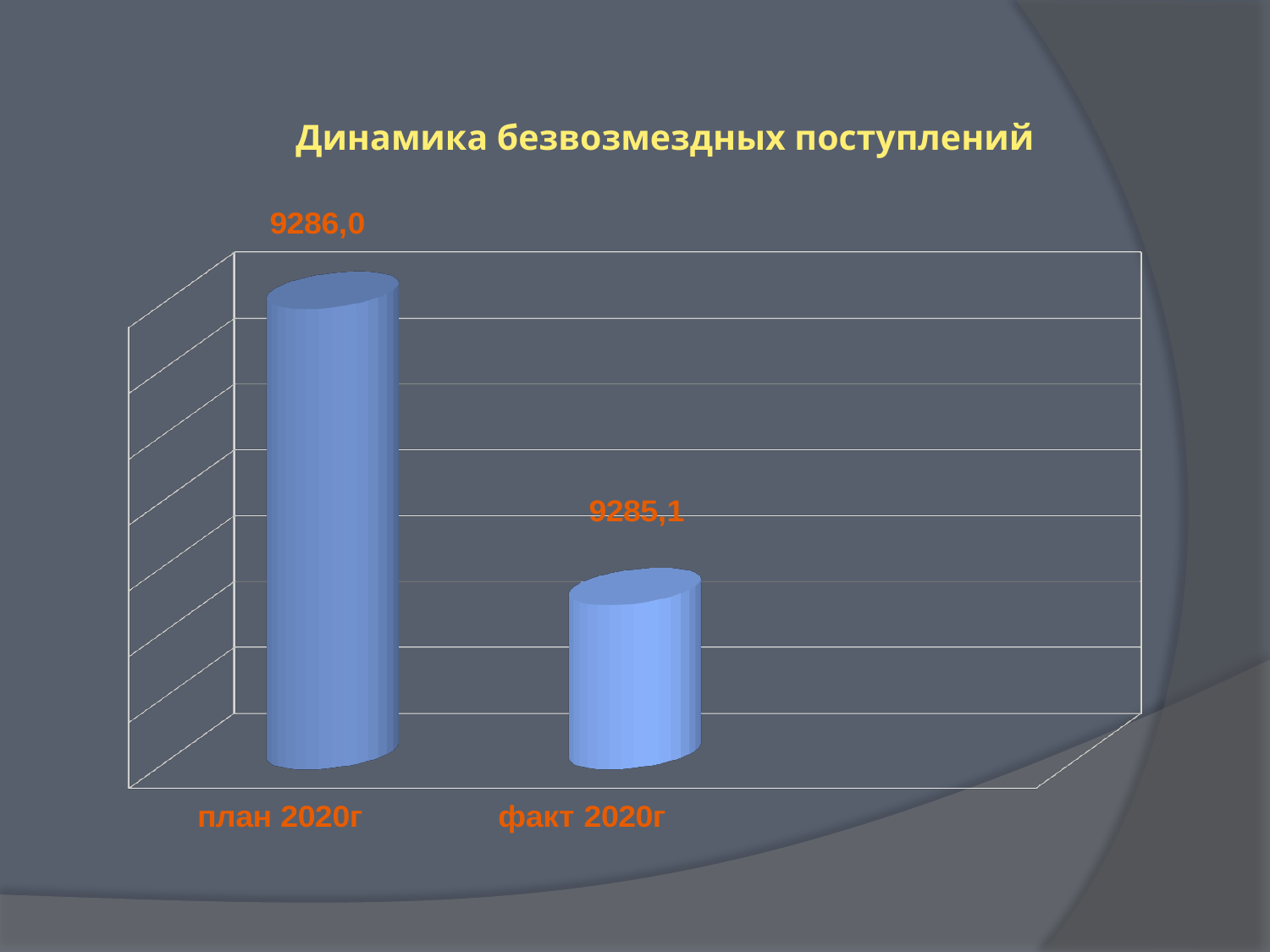
What kind of chart is shown on the slide? bar chart Which is larger, the value for план 2020г or the value for факт 2020г? план 2020г How many categories are shown on the chart? 2 What colour are the bars on the chart? blue Which category has the lowest value? факт 2020г What is the value for факт 2020г? 9285,1 Do the values rise or fall from план 2020г to факт 2020г? fall What is the difference between the values for план 2020г and факт 2020г? 0,9 What is the value for план 2020г? 9286,0 What is the title of the chart? Динамика безвозмездных поступлений Which category has the highest value? план 2020г